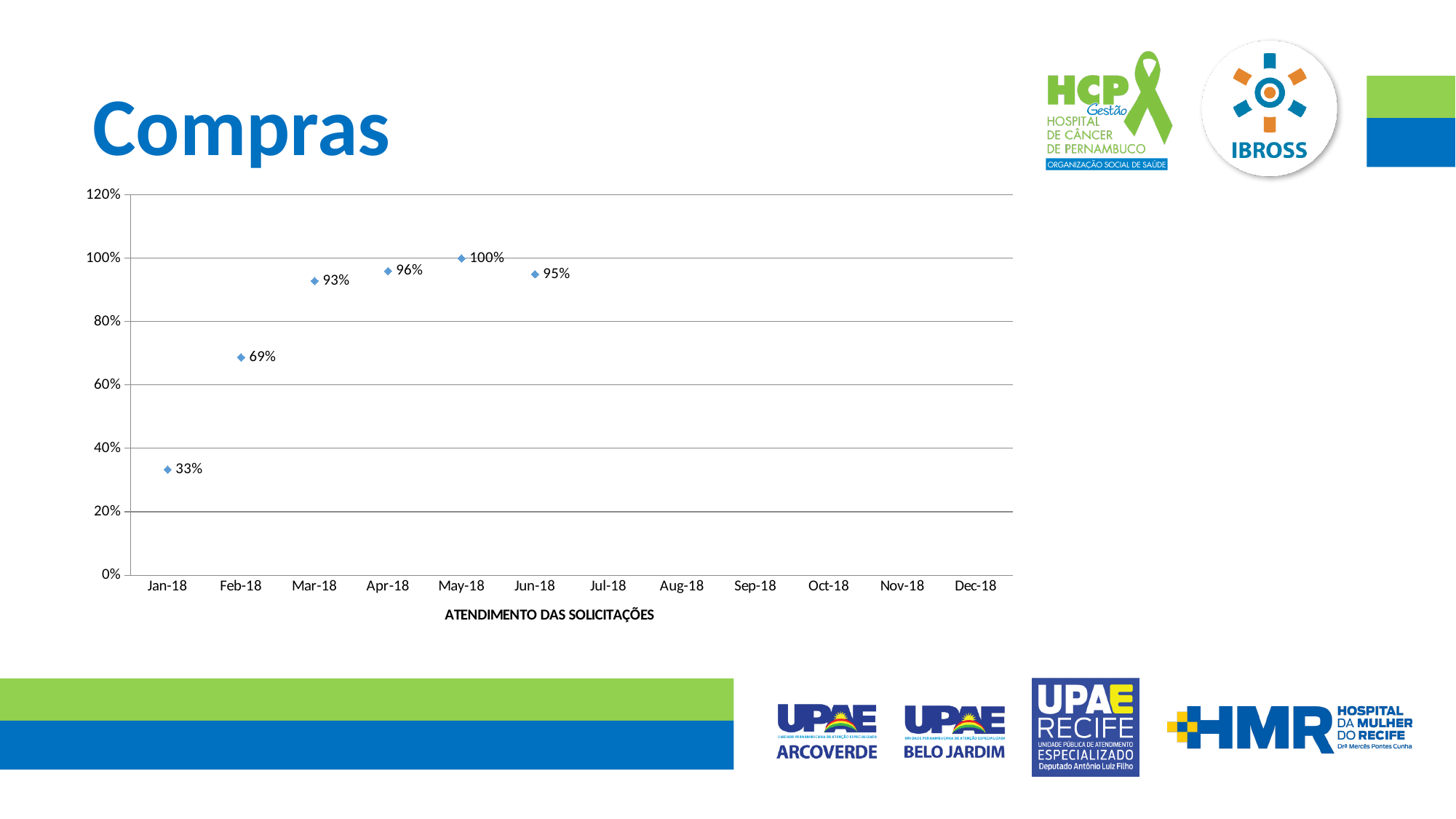
What is the difference between the values for May-18 and Jun-18? 5% What is the value for Mar-18? 93% What label appears below the x axis of the chart? ATENDIMENTO DAS SOLICITAÇÕES Is the value for Feb-18 greater or less than 60%? greater Which month has the lowest value? Jan-18 Do the values rise or fall from Jan-18 to May-18? rise What is the value for Jan-18? 33% What is the value for Jun-18? 95% Which is larger, the value for Apr-18 or the value for Mar-18? Apr-18 Which month has the highest value? May-18 How many data points are plotted on the chart? 6 What is the difference between the values for Feb-18 and Jan-18? 36%